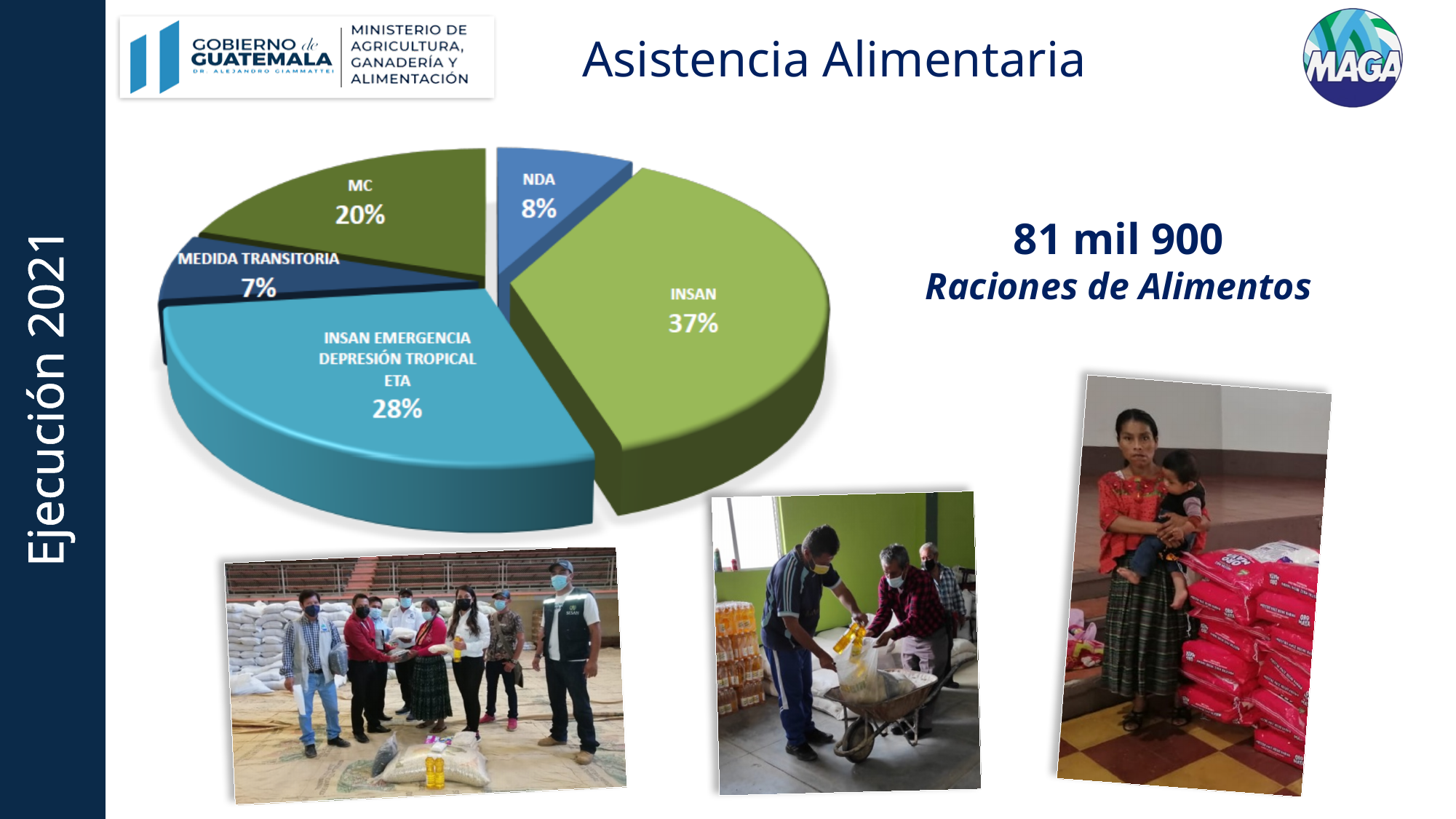
What percentage of the pie chart is INSAN? 37% How many categories are shown in the pie chart? 5 Which is larger, the MC slice or the NDA slice? MC Which category has the smallest slice of the pie chart? MEDIDA TRANSITORIA What is the title of the slide containing the pie chart? Asistencia Alimentaria What is the difference in percentage points between INSAN and INSAN EMERGENCIA DEPRESIÓN TROPICAL ETA? 9 Which category has the largest slice of the pie chart? INSAN What is the value for MC in the pie chart? 20% What type of chart is shown on the slide? Pie chart What share does the NDA slice represent? 8% What percentage is shown for MEDIDA TRANSITORIA? 7% What share of the pie is INSAN EMERGENCIA DEPRESIÓN TROPICAL ETA? 28%